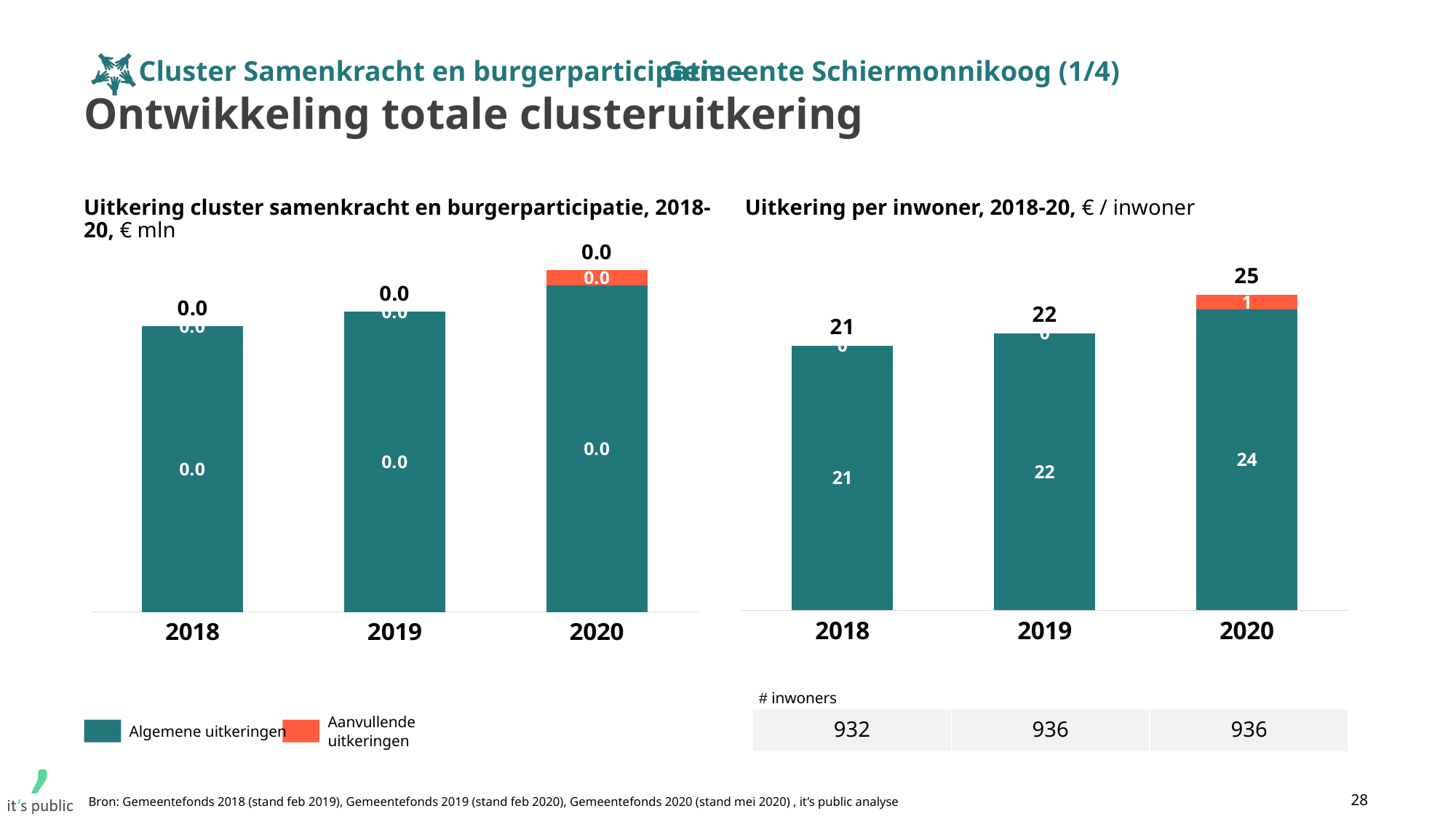
In the chart 'Uitkering per inwoner, 2018-20', do the totals rise or fall from 2018 to 2020? rise How many years are shown on the x axis of the left chart 'Uitkering cluster samenkracht en burgerparticipatie, 2018-20'? 3 In the chart 'Uitkering per inwoner, 2018-20', what is the total of the stacked bar for 2020 (Algemene plus Aanvullende uitkeringen)? 25 In the chart 'Uitkering per inwoner, 2018-20', which year has the lowest total? 2018 How many series does the legend on the slide list? 2 In the chart 'Uitkering per inwoner, 2018-20', what is the value of Aanvullende uitkeringen for 2020? 1 In the chart 'Uitkering per inwoner, 2018-20', what is the total value shown above the bar for 2020? 25 In the left chart 'Uitkering cluster samenkracht en burgerparticipatie, 2018-20', what total value is printed above the bar for 2019? 0.0 In the chart 'Uitkering per inwoner, 2018-20', what is the value of Algemene uitkeringen for 2019? 22 In the chart 'Uitkering per inwoner, 2018-20', which year has the highest total? 2020 What kind of chart is the right chart 'Uitkering per inwoner, 2018-20'? stacked bar chart In the chart 'Uitkering per inwoner, 2018-20', what is the difference between the total for 2020 and the total for 2018? 4